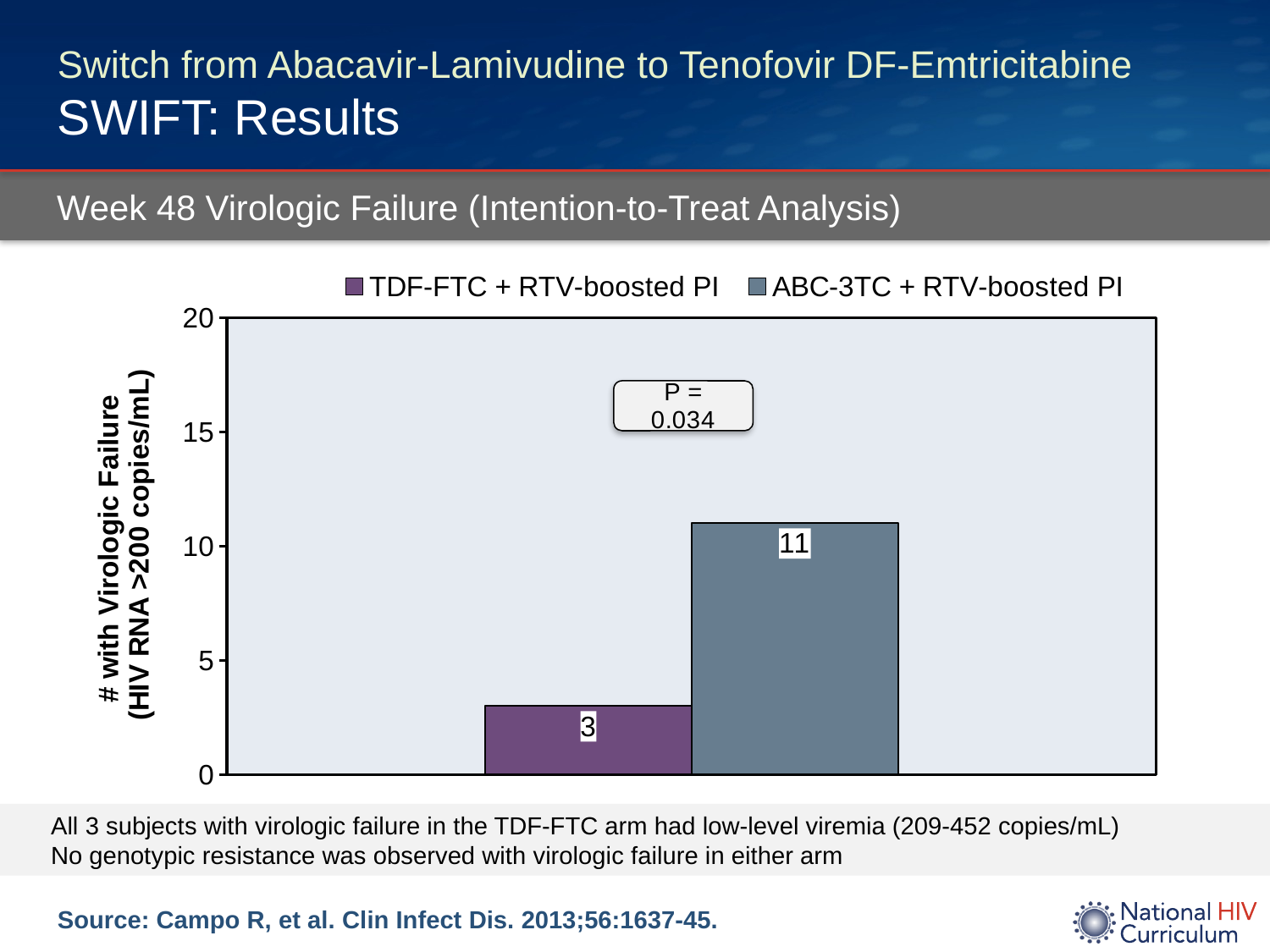
Which arm has the lower number with virologic failure? TDF-FTC + RTV-boosted PI What is the number with virologic failure for the ABC-3TC + RTV-boosted PI arm? 11 Is the value for the TDF-FTC + RTV-boosted PI arm greater or less than 5? less Is the value for the ABC-3TC + RTV-boosted PI arm greater or less than 10? greater What kind of chart is shown on the slide? Bar chart How many bars are plotted in the chart? 2 What is the number with virologic failure for the TDF-FTC + RTV-boosted PI arm? 3 What is the difference in the number with virologic failure between the ABC-3TC + RTV-boosted PI arm and the TDF-FTC + RTV-boosted PI arm? 8 How many series does the legend list? 2 Is the number with virologic failure larger for the TDF-FTC + RTV-boosted PI arm or the ABC-3TC + RTV-boosted PI arm? ABC-3TC + RTV-boosted PI Which arm has the higher number with virologic failure? ABC-3TC + RTV-boosted PI What P value is shown on the chart? P = 0.034